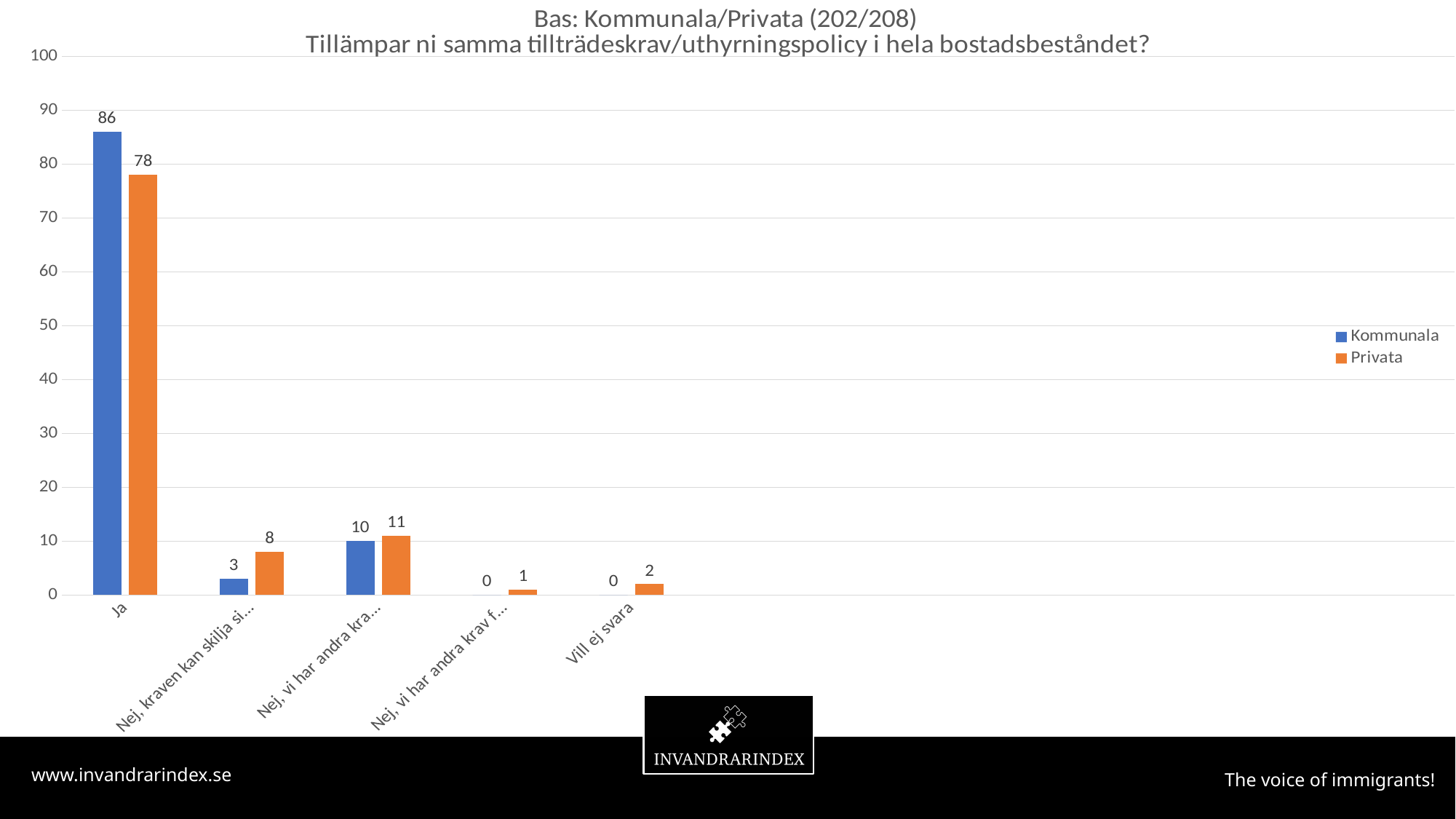
Which category has the highest value for Kommunala? Ja How many series does the legend list? 2 What is the value for Privata in the "Ja" category? 78 What is the value for Kommunala in the "Ja" category? 86 Is the Privata value for "Ja" greater or less than 70? greater How many categories are shown on the x axis? 5 What kind of chart is shown on the slide? Bar chart What is the difference between the Kommunala and Privata values in the "Ja" category? 8 In the "Ja" category, which series has the larger value, Kommunala or Privata? Kommunala What is the value for Privata in the "Vill ej svara" category? 2 In the "Vill ej svara" category, which series has the larger value, Kommunala or Privata? Privata What is the value for Kommunala in the "Vill ej svara" category? 0